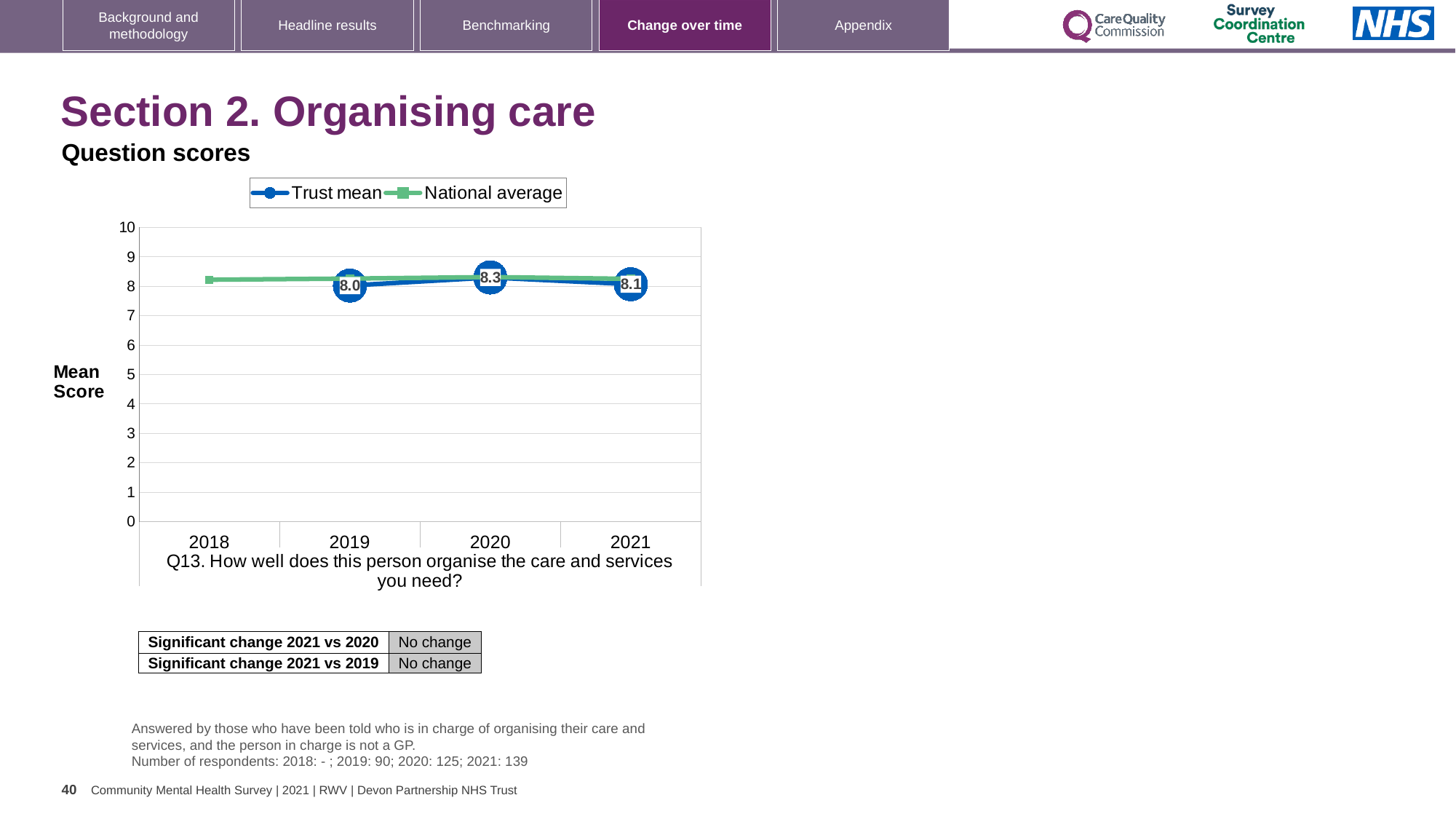
How many years are shown on the x axis? 4 In which year is the Trust mean lowest among the labelled years? 2019 What is the Trust mean for 2019? 8.0 What is the Trust mean for 2021? 8.1 What is the difference between the Trust mean in 2020 and in 2019? 0.3 Does the Trust mean rise or fall from 2019 to 2020? rise How many series does the legend list? 2 Which year has the larger Trust mean, 2019 or 2021? 2021 What kind of chart is shown on the slide? line chart Is the National average for 2018 greater or less than 5? greater In which year is the Trust mean highest? 2020 What is the Trust mean for 2020? 8.3